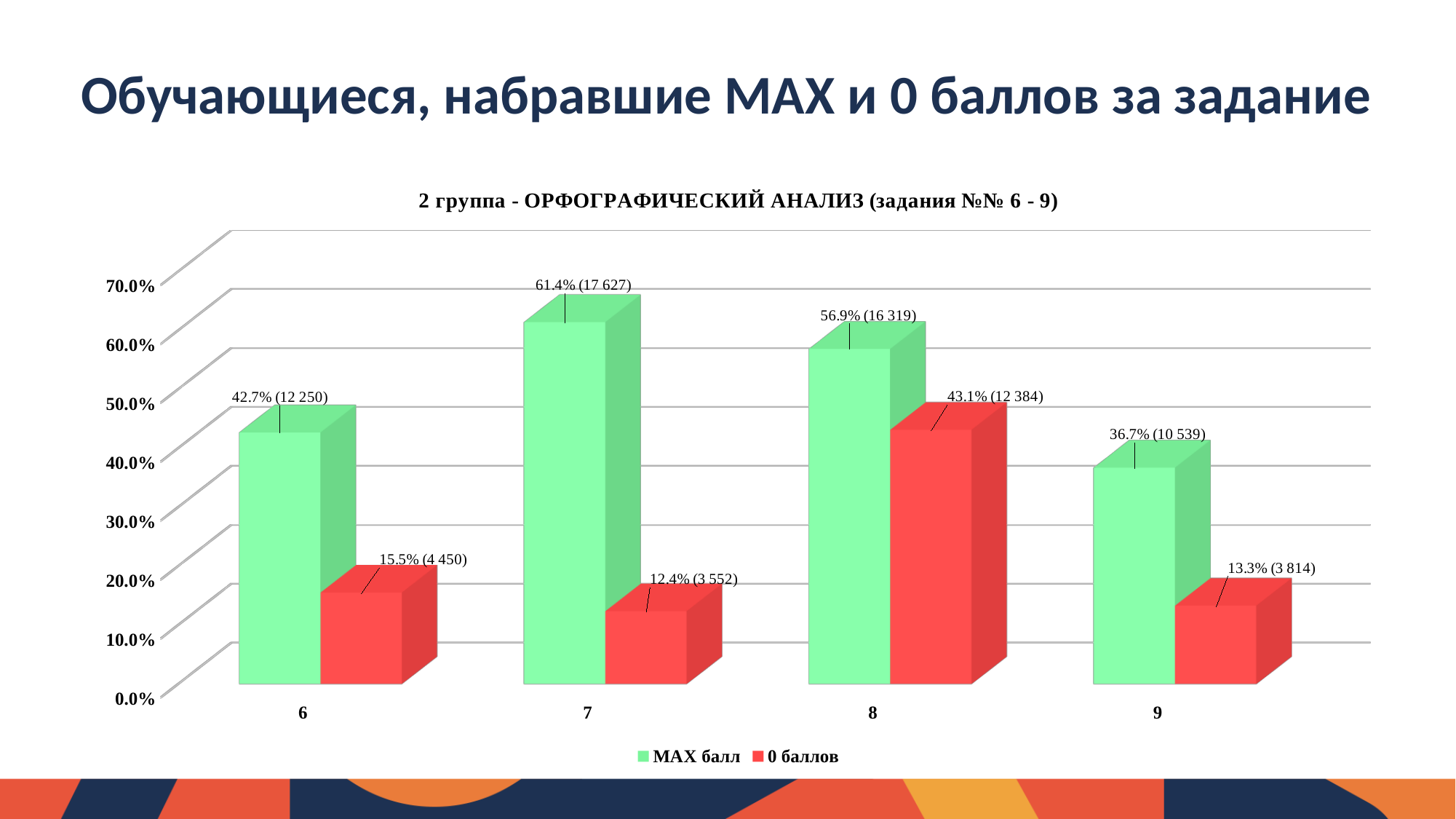
Which task has the lowest 0 баллов value? 7 Which task has the highest МАХ балл value? 7 What is the difference in percentage points between the МАХ балл and 0 баллов values for task 8? 13.8% What is the value of the 0 баллов series for task 6? 15.5% (4 450) How many series does the legend list? 2 What is the value of the 0 баллов series for task 8? 43.1% (12 384) What is the title of the chart? 2 группа - ОРФОГРАФИЧЕСКИЙ АНАЛИЗ (задания №№ 6 - 9) How many tasks (categories) are shown on the x axis? 4 What is the value of the МАХ балл series for task 9? 36.7% (10 539) What kind of chart is shown on the slide? Bar chart What is the value of the МАХ балл series for task 7? 61.4% (17 627) Which is larger for task 6: the МАХ балл value or the 0 баллов value? МАХ балл